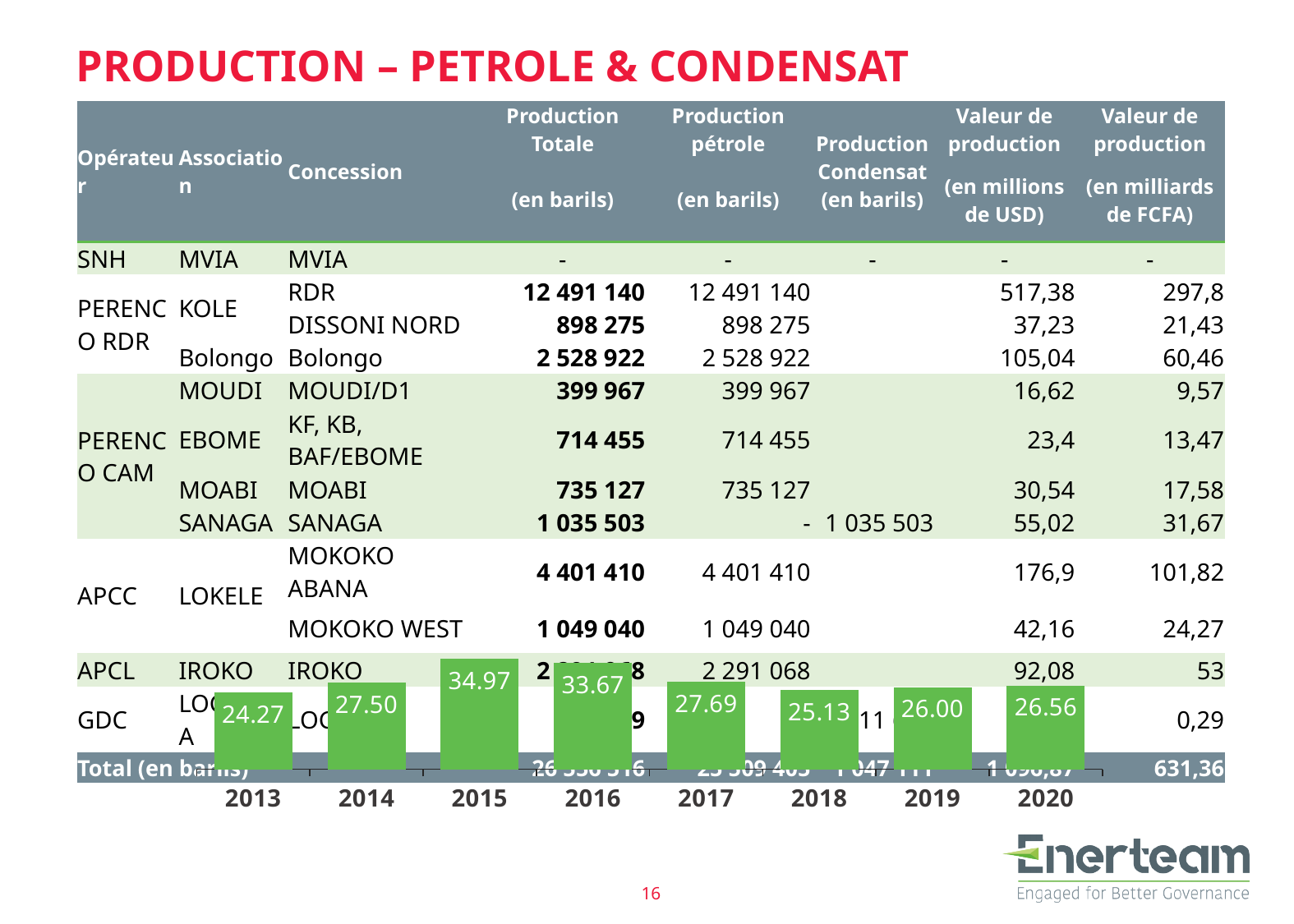
In the bar chart, what is the value for 2013? 24.27 In the bar chart, which is larger, the value for 2014 or the value for 2017? 2017 What type of chart is overlaid on the table at the bottom of the slide? bar chart In the bar chart, what is the value for 2020? 26.56 In the bar chart, which year has the highest value? 2015 In the bar chart, does the value rise or fall from 2013 to 2015? rise What colour are the bars in the bar chart? green How many years are shown on the x axis of the bar chart? 8 In the bar chart, what is the difference between the values for 2015 and 2016? 1.30 In the bar chart, what is the value for 2018? 25.13 In the bar chart, what is the value for 2015? 34.97 In the bar chart, which year has the lowest value? 2013